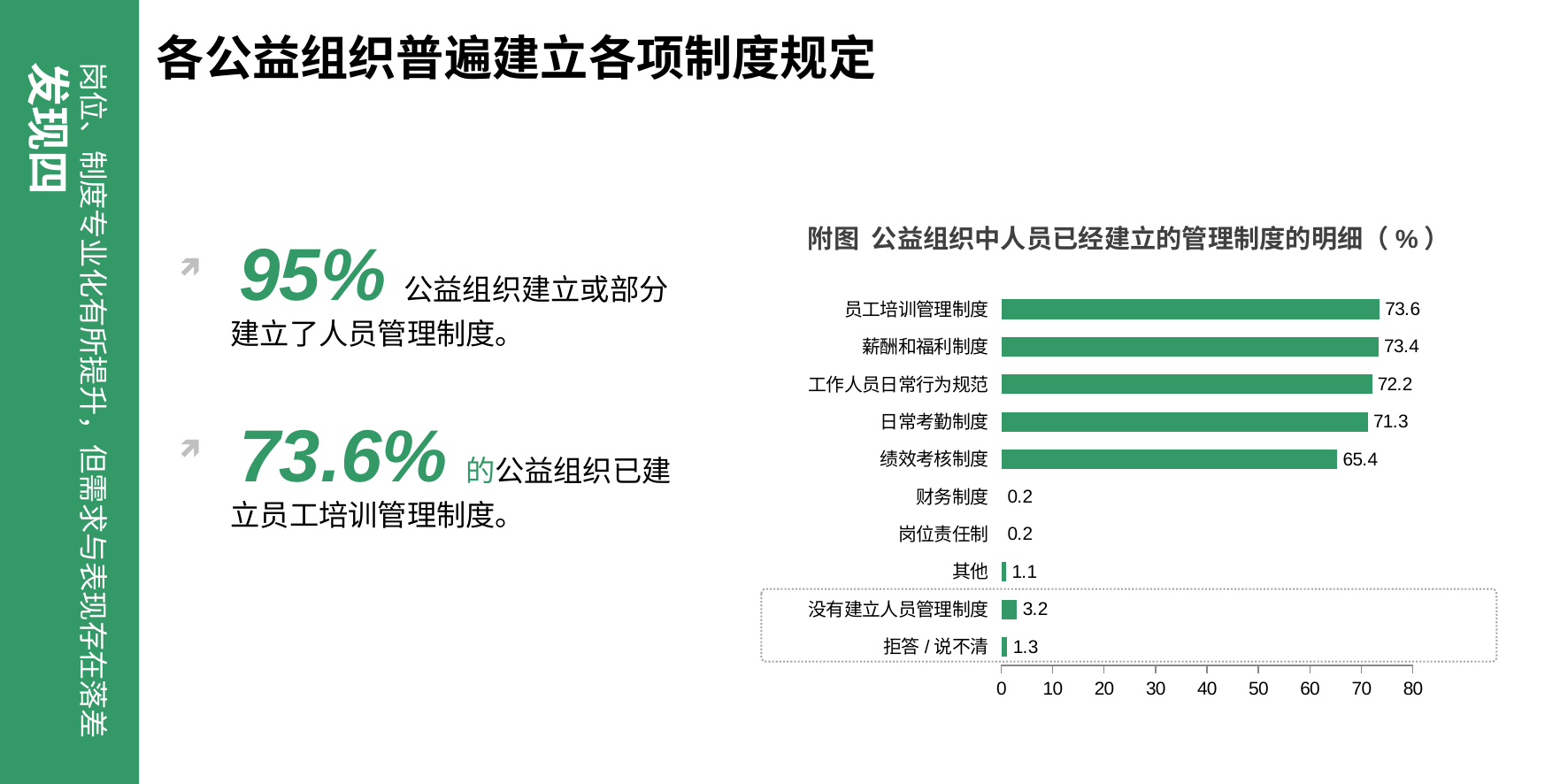
What is the difference between the values for 员工培训管理制度 and 绩效考核制度? 8.2 Which is larger, the value for 日常考勤制度 or the value for 绩效考核制度? 日常考勤制度 What is the difference between the values for 薪酬和福利制度 and 没有建立人员管理制度? 70.2 Which category has the highest value? 员工培训管理制度 How many categories are shown in the chart? 10 What is the value for 拒答 / 说不清? 1.3 What is the value for 员工培训管理制度? 73.6 What is the highest tick value shown on the horizontal axis? 80 What is the value for 绩效考核制度? 65.4 What kind of chart is shown on the slide? bar chart What is the value for 没有建立人员管理制度? 3.2 Is the value for 绩效考核制度 greater or less than 70? less